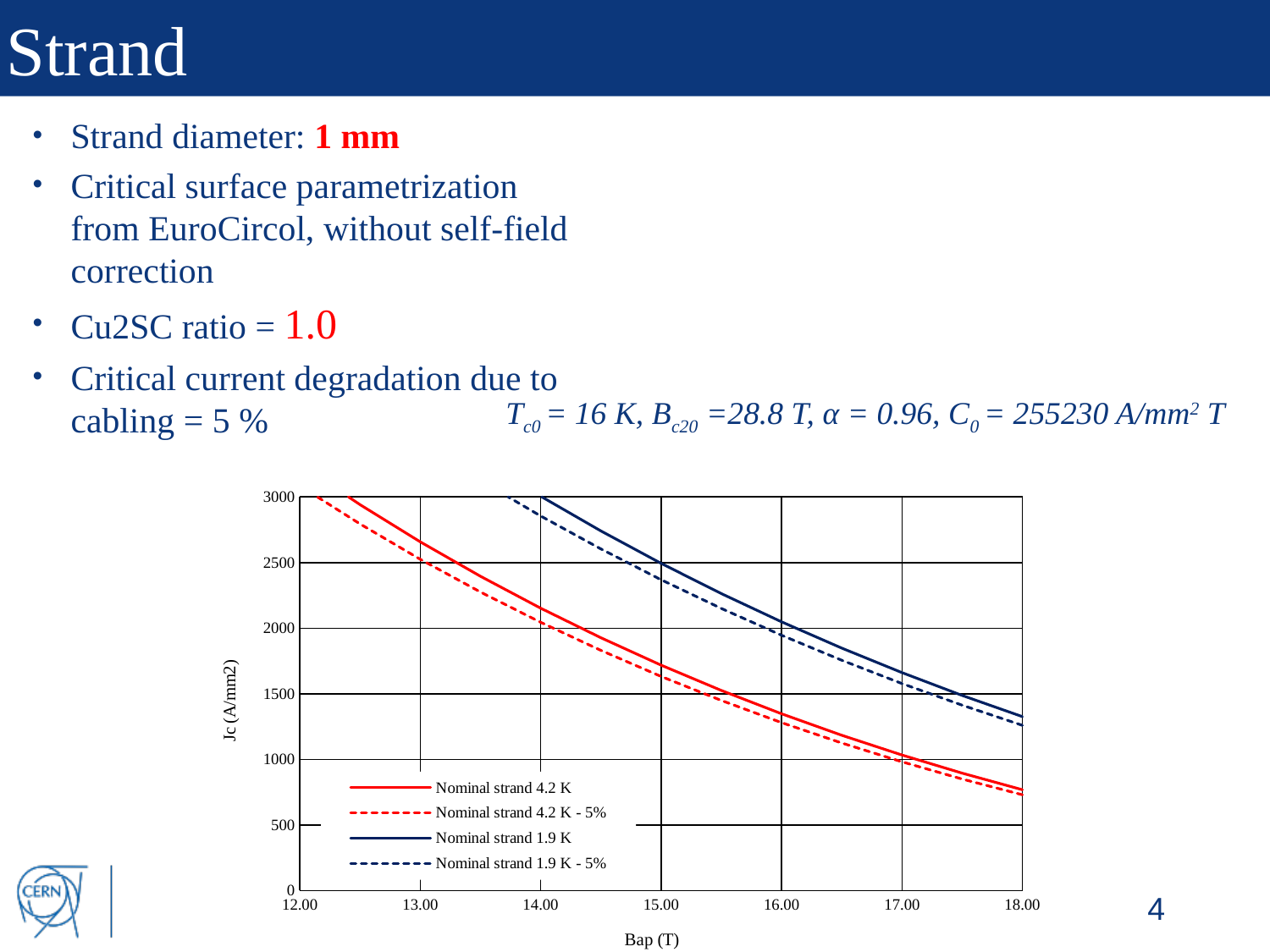
Which series has the highest Jc at 17.00 T? Nominal strand 1.9 K Is the value for Nominal strand 1.9 K at 18.00 T greater or less than 1500? less Which series has the lowest Jc at 14.00 T? Nominal strand 4.2 K - 5% How many series does the chart legend list? 4 What kind of chart is shown on the slide? line chart At 16.00 T, which is larger: Nominal strand 1.9 K or Nominal strand 4.2 K? Nominal strand 1.9 K Do the Jc values rise or fall as Bap increases along the x axis? fall What is the label of the y axis of the chart? Jc (A/mm2) Is the value for Nominal strand 4.2 K at 15.00 T greater or less than 1500? greater Is the value for Nominal strand 1.9 K at 17.00 T greater or less than 1500? greater What is the label of the x axis of the chart? Bap (T)